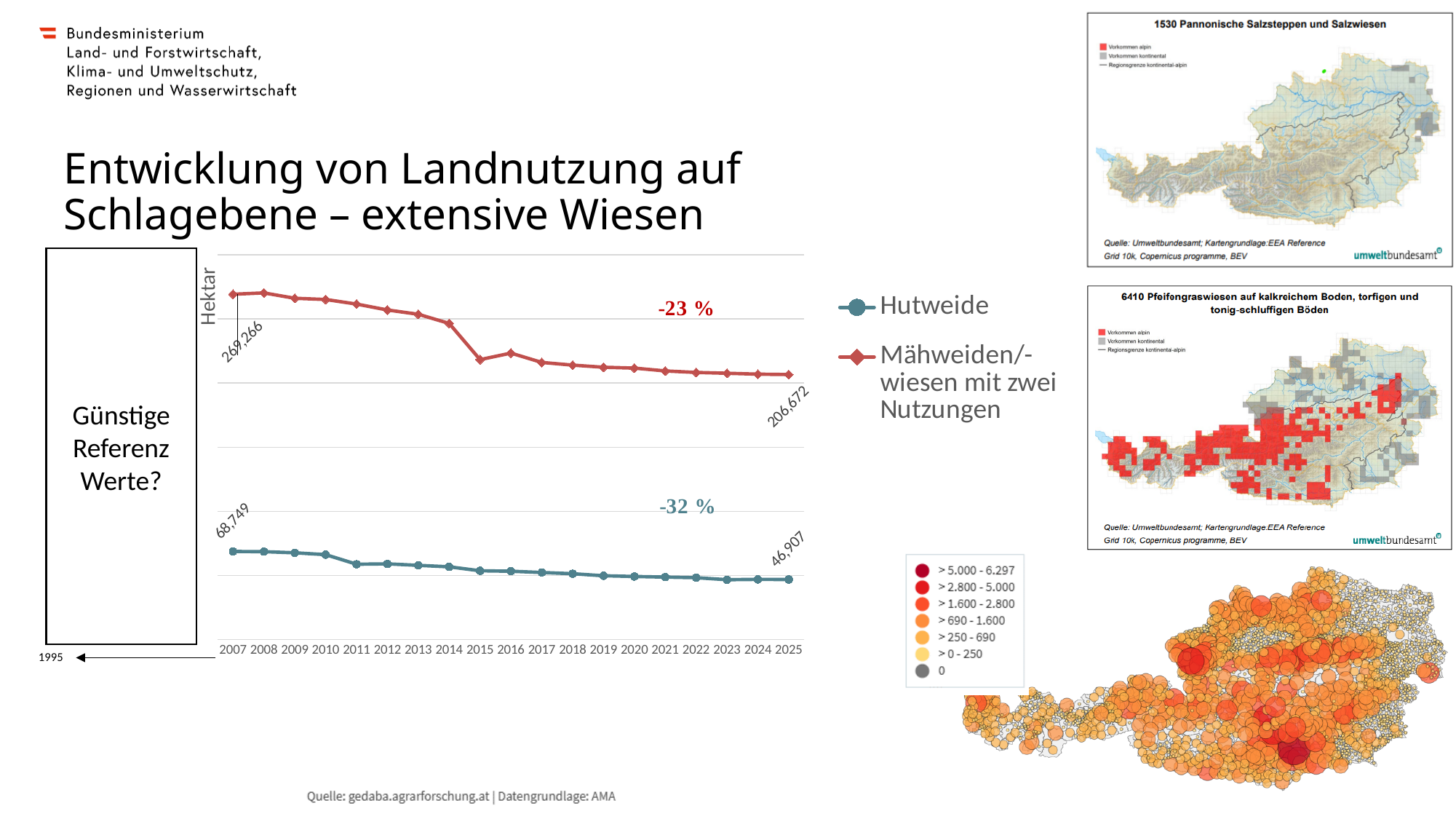
Do the values for Hutweide rise or fall from 2007 to 2025? Fall What percentage change is annotated for the Hutweide series? -32 % By how much did the value for Mähweiden/-wiesen mit zwei Nutzungen decrease from 2007 to 2025? 62,594 What is the value for Mähweiden/-wiesen mit zwei Nutzungen in 2007? 269,266 What kind of chart is used to show the development of land use? Line chart What is the value for Hutweide in 2007? 68,749 By how much did the value for Hutweide decrease from 2007 to 2025? 21,842 How many years are shown on the x axis of the line chart? 19 Which series has the higher value in 2025, Hutweide or Mähweiden/-wiesen mit zwei Nutzungen? Mähweiden/-wiesen mit zwei Nutzungen What is the value for Hutweide in 2025? 46,907 How many series does the legend of the line chart list? 2 What is the value for Mähweiden/-wiesen mit zwei Nutzungen in 2025? 206,672